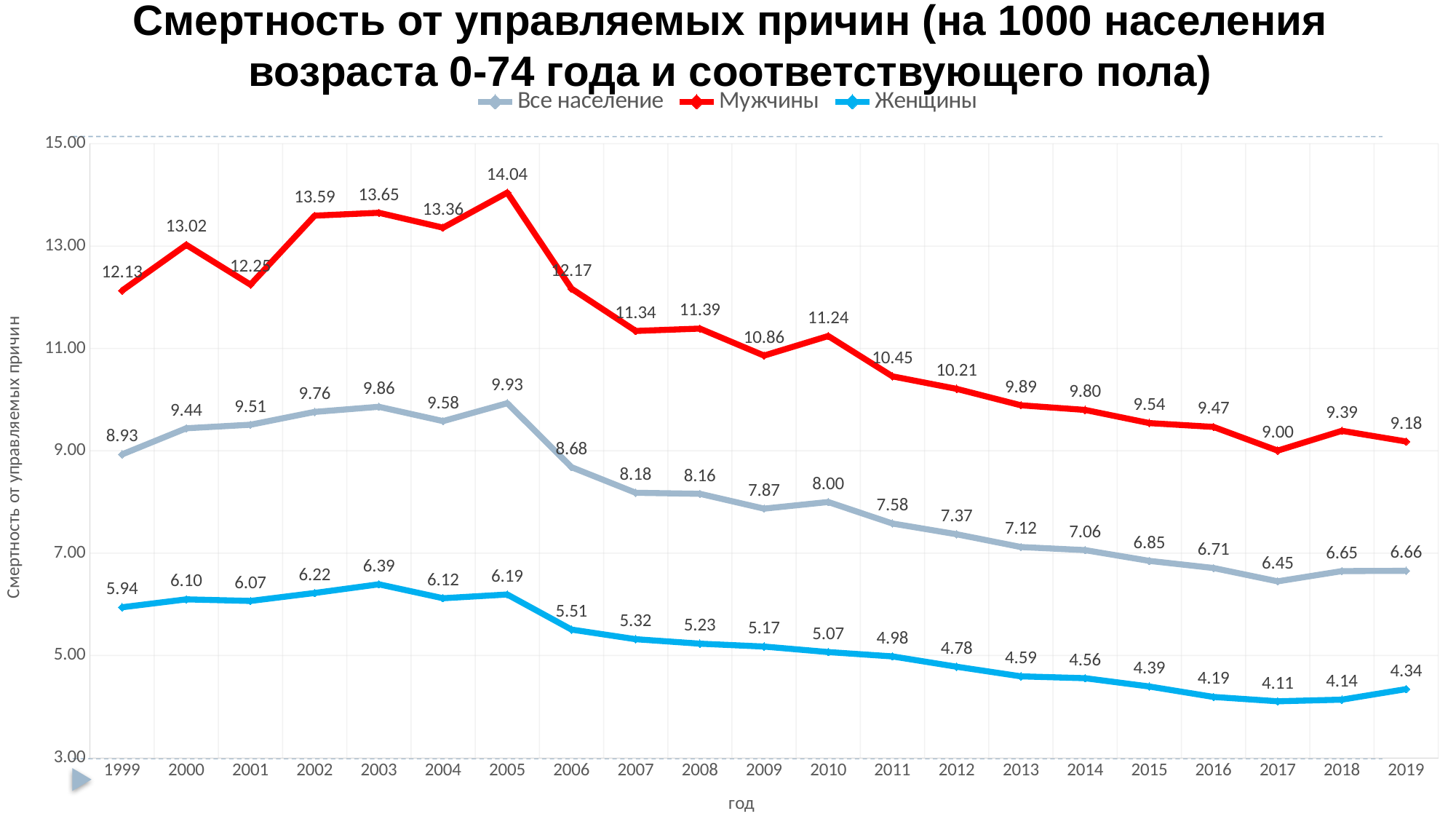
What type of chart is shown on the slide? line chart What is the value for Все население in 2010? 8.00 How many series does the legend list? 3 In which year does the Мужчины series reach its highest value? 2005 What is the difference between the Мужчины and Женщины values in 2019? 4.84 Does the Все население series overall rise or fall from 1999 to 2019? fall How many years are plotted along the x axis? 21 Which is larger for Мужчины: the value in 2000 or the value in 2001? 2000 What is the value for Мужчины in 2005? 14.04 In which year does the Женщины series reach its lowest value? 2017 What is the label of the vertical axis? Смертность от управляемых причин What is the value for Женщины in 2019? 4.34